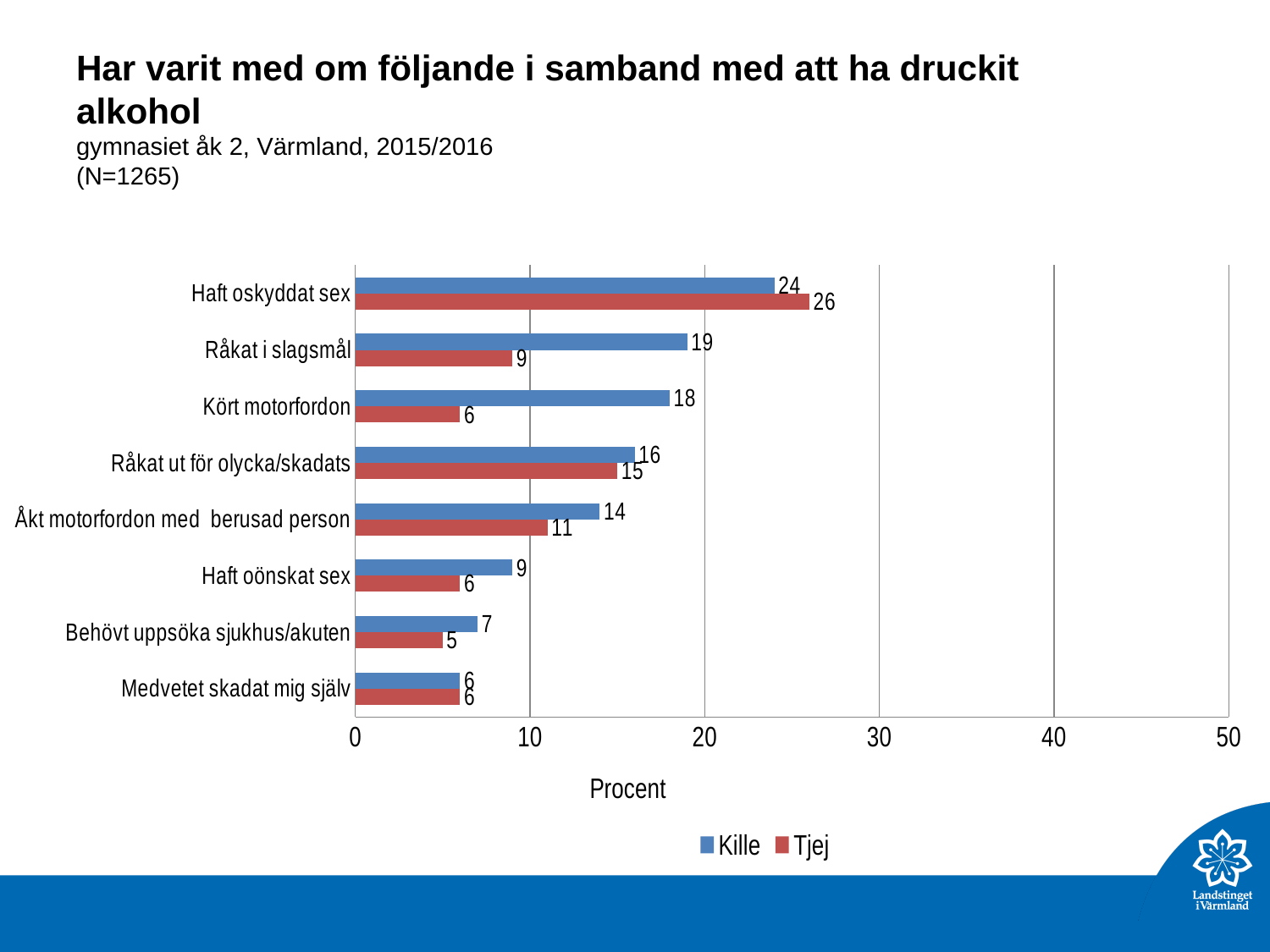
Is the Kille value for 'Råkat i slagsmål' greater or less than 10? greater What is the difference between the Kille and Tjej values for 'Kört motorfordon'? 12 What kind of chart is shown on the slide? Bar chart What is the label of the x axis? Procent How many series does the legend list? 2 What is the value for Kille for 'Haft oskyddat sex'? 24 Which is larger for 'Haft oskyddat sex', the Kille value or the Tjej value? Tjej What is the value for Tjej for 'Kört motorfordon'? 6 Which category has the lowest value for Kille? Medvetet skadat mig själv What is the value for Tjej for 'Råkat i slagsmål'? 9 How many categories are shown on the chart? 8 Which category has the highest value for Tjej? Haft oskyddat sex